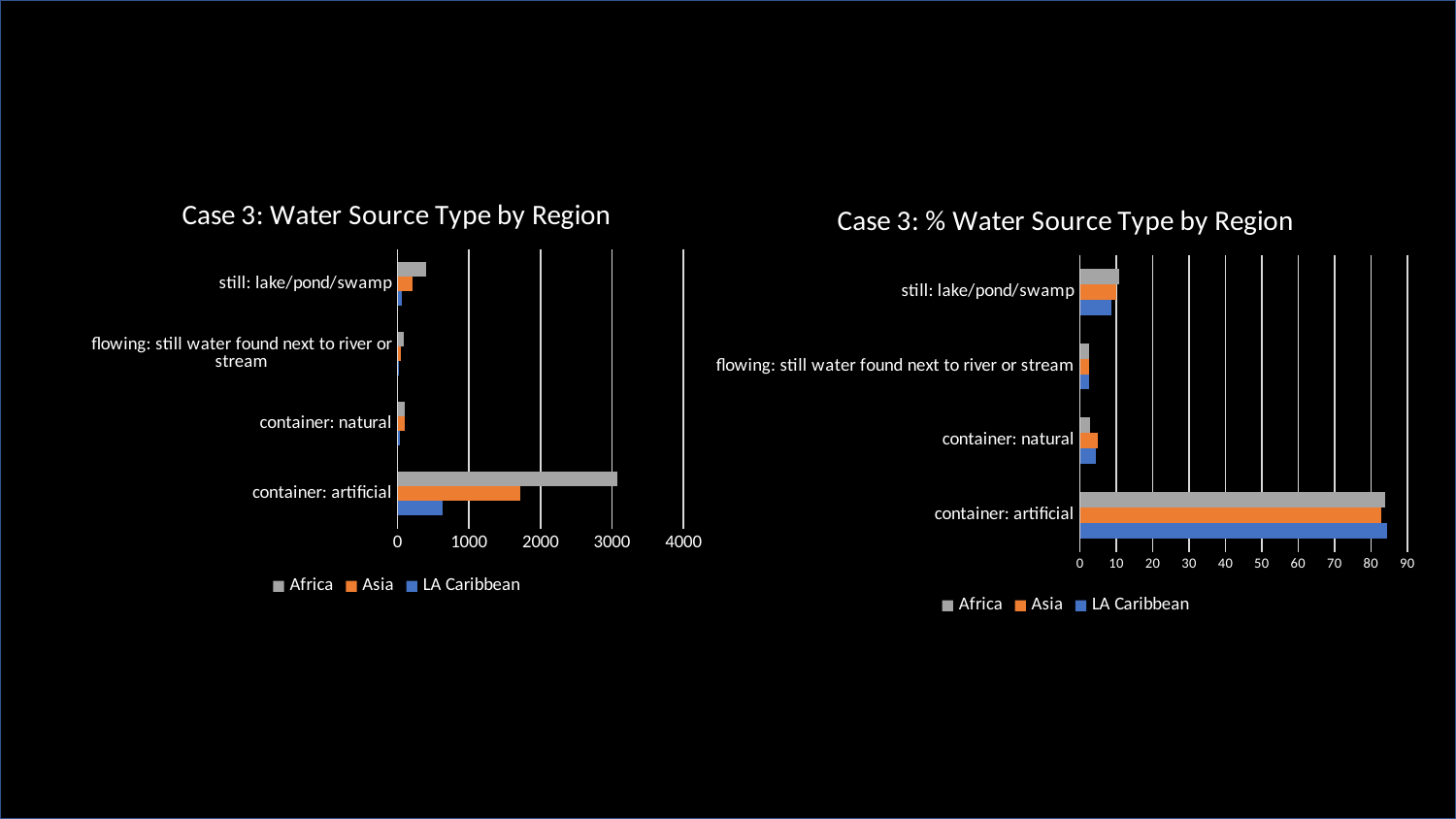
On the chart titled "Case 3: Water Source Type by Region", what kind of chart is shown? bar chart On the chart titled "Case 3: Water Source Type by Region", is the Africa value for container: artificial greater or less than 2000? greater On the chart titled "Case 3: Water Source Type by Region", which is larger for container: artificial, Africa or Asia? Africa On the chart titled "Case 3: Water Source Type by Region", is the LA Caribbean value for container: artificial greater or less than 1000? less On the chart titled "Case 3: Water Source Type by Region", how many categories are plotted? 4 On the chart titled "Case 3: % Water Source Type by Region", how many series does the legend list? 3 On the chart titled "Case 3: % Water Source Type by Region", which series is shown in orange? Asia On the chart titled "Case 3: Water Source Type by Region", is the Asia value for container: artificial greater or less than 1000? greater On the chart titled "Case 3: % Water Source Type by Region", which category has the highest value for LA Caribbean? container: artificial On the chart titled "Case 3: Water Source Type by Region", which category has the highest value for Africa? container: artificial